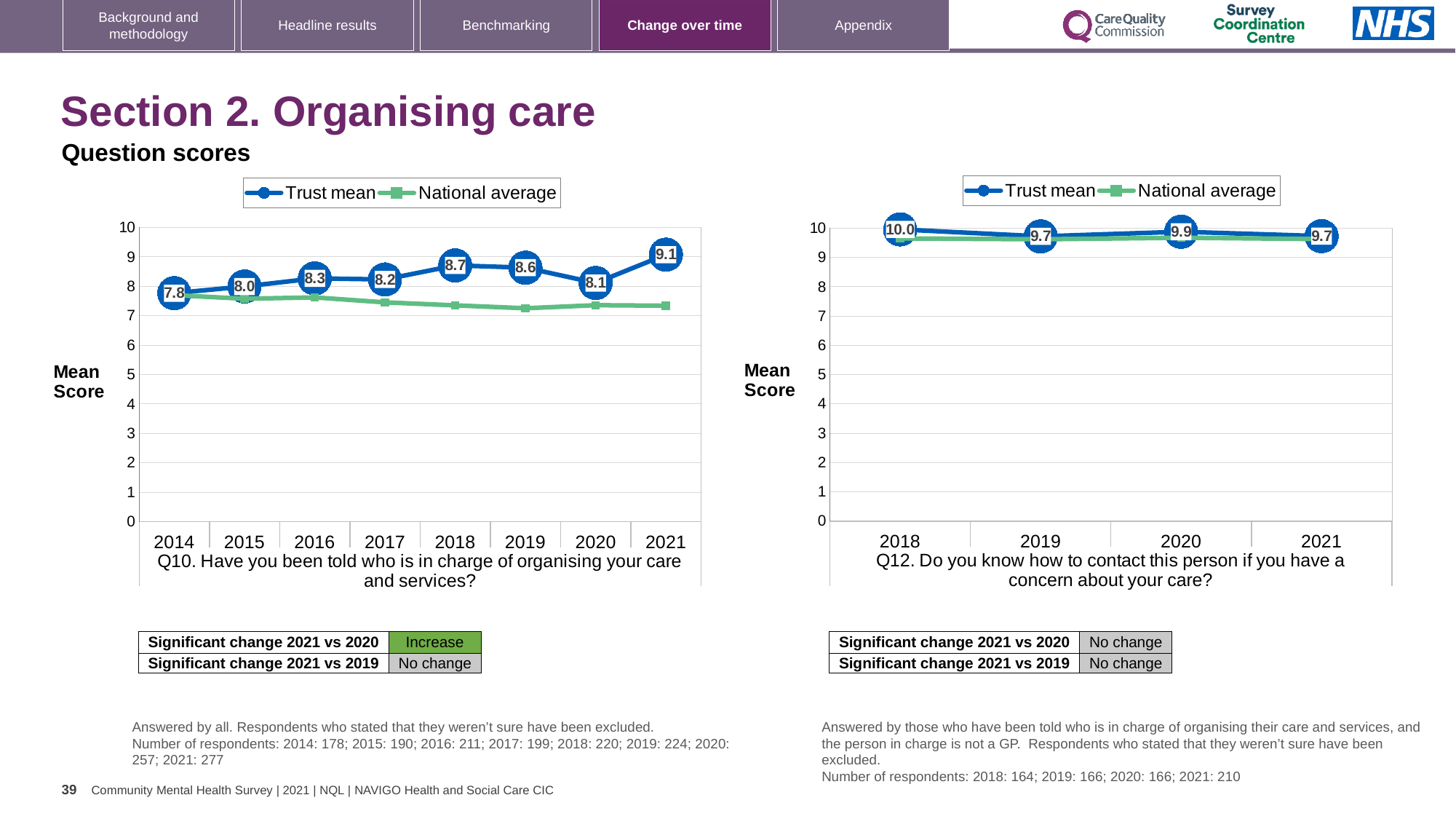
On the Q10 chart (left), which year has the lowest Trust mean score? 2014 On the Q10 chart (left), how many years are shown on the x axis? 8 What kind of chart is the Q12 chart (right)? Line chart On the Q10 chart (left), what is the Trust mean score for 2014? 7.8 On the Q12 chart (right), how many series does the legend list? 2 On the Q12 chart (right), what is the difference between the Trust mean scores for 2018 and 2019? 0.3 On the Q10 chart (left), is the National average for 2021 greater or less than 8? less On the Q12 chart (right), what is the Trust mean score for 2018? 10.0 On the Q10 chart (left), what is the Trust mean score for 2021? 9.1 On the Q10 chart (left), is the Trust mean score for 2018 or 2020 larger? 2018 On the Q10 chart (left), what is the difference between the Trust mean scores for 2021 and 2020? 1.0 On the Q10 chart (left), which year has the highest Trust mean score? 2021